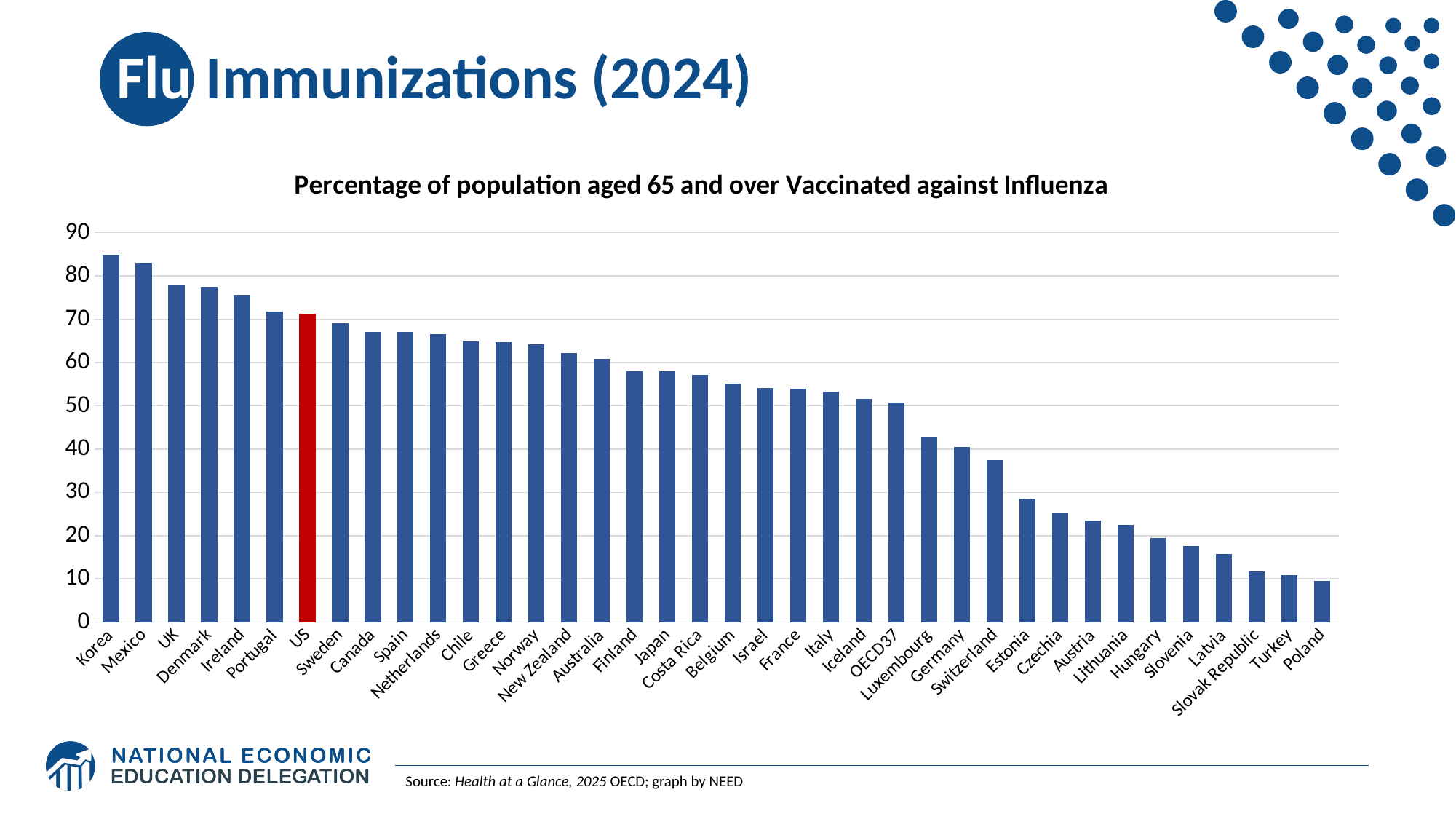
Is the value for Poland greater or less than 20? less Is the value for Korea greater or less than 80? greater Which country has the highest percentage of population aged 65 and over vaccinated against influenza? Korea Which has a higher vaccination percentage, the US or Germany? US How many bars (countries and groups) are plotted on the chart? 38 Do the values rise or fall moving from left to right along the x axis? fall Is the value for Estonia greater or less than 30? less What kind of chart is shown on the slide? bar chart Which bar is highlighted in red on the chart? US Which country has the lowest percentage of population aged 65 and over vaccinated against influenza? Poland